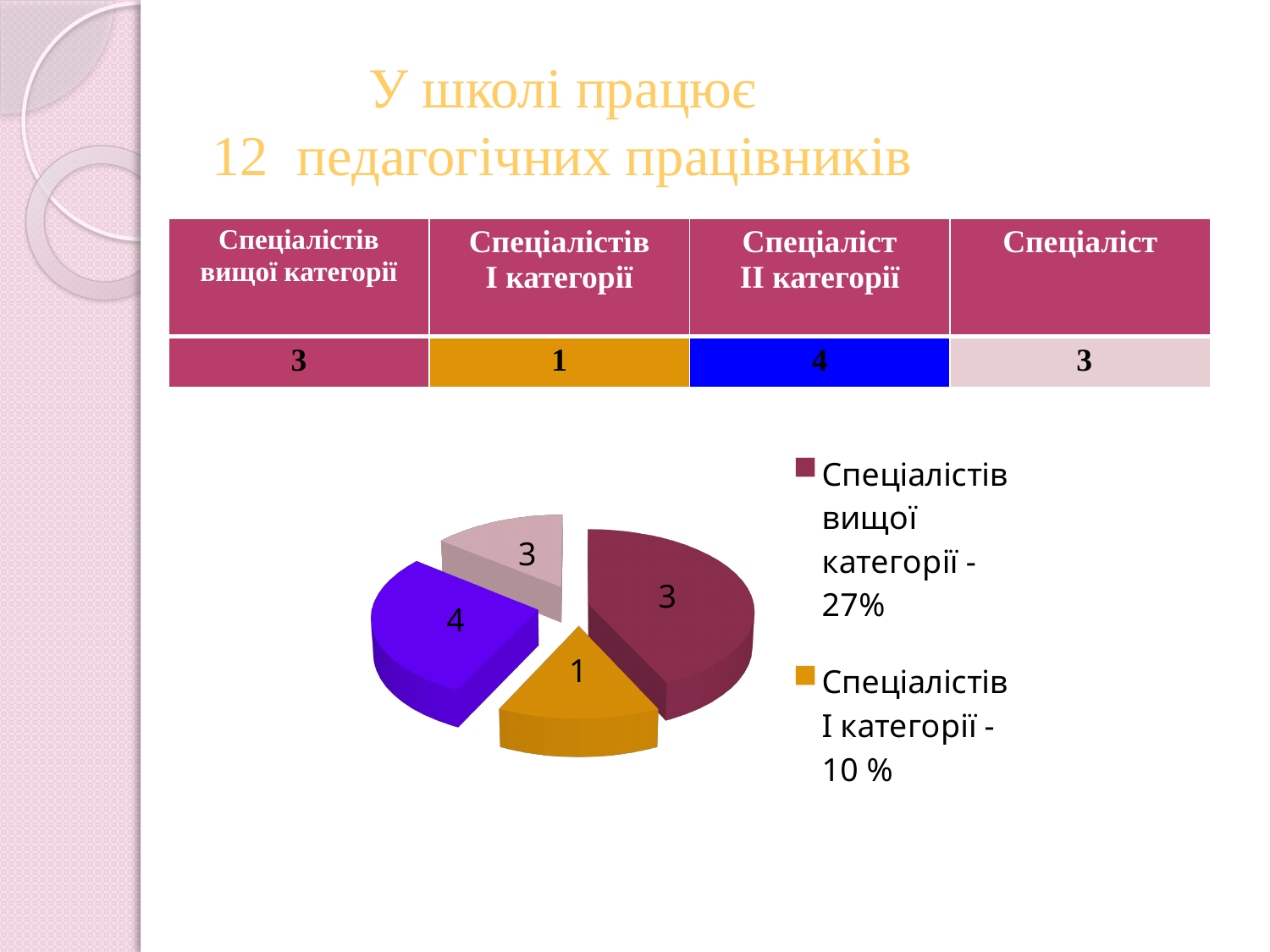
What value is shown on the blue slice of the pie chart? 4 What value is shown on the dark magenta slice (Спеціалістів вищої категорії)? 3 How many slices does the pie chart have? 4 What is the value of the smallest slice in the pie chart? 1 What value is shown on the orange slice (Спеціалістів I категорії)? 1 What kind of chart is shown on the slide? pie chart Which is larger, the blue slice or the orange slice? the blue slice What share of the pie does the legend give for Спеціалістів вищої категорії? 27% What is the difference between the blue slice and the orange slice? 3 What is the total of all slice values in the pie chart? 11 How many entries does the pie chart's legend list? 2